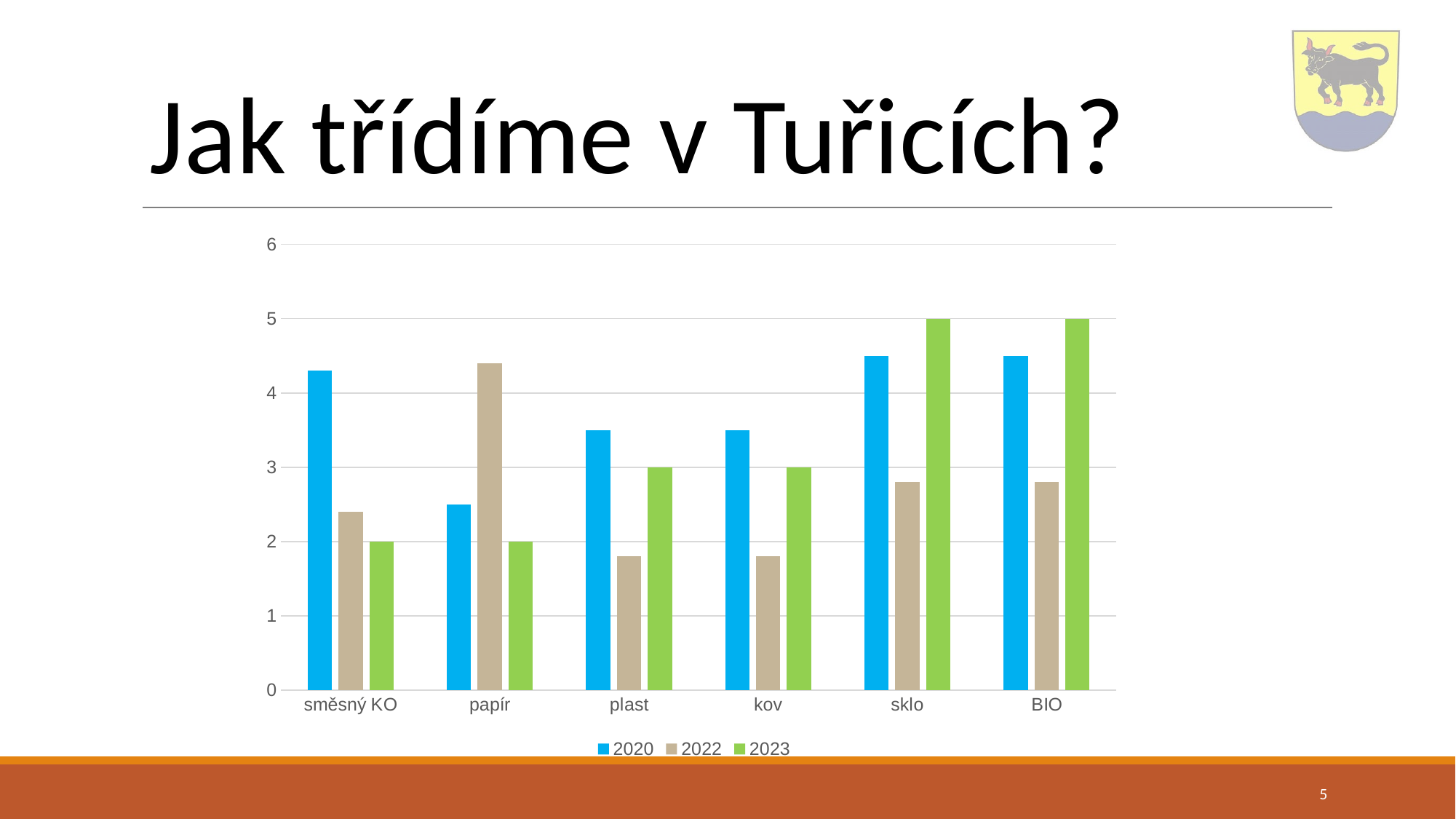
What is the value for sklo in the 2023 series? 5 What are the entries listed in the legend? 2020, 2022, 2023 What is the difference between the 2023 values for sklo and plast? 2 How many series does the legend list? 3 What is the value for směsný KO in the 2023 series? 2 For papír, which series has the larger value, 2020 or 2022? 2022 What kind of chart is shown on the slide? bar chart Is the 2020 value for směsný KO greater or less than 4? greater Which category has the highest value in the 2022 series? papír What is the value for plast in the 2023 series? 3 Is the 2022 value for plast greater or less than 2? less How many categories are shown on the x axis? 6